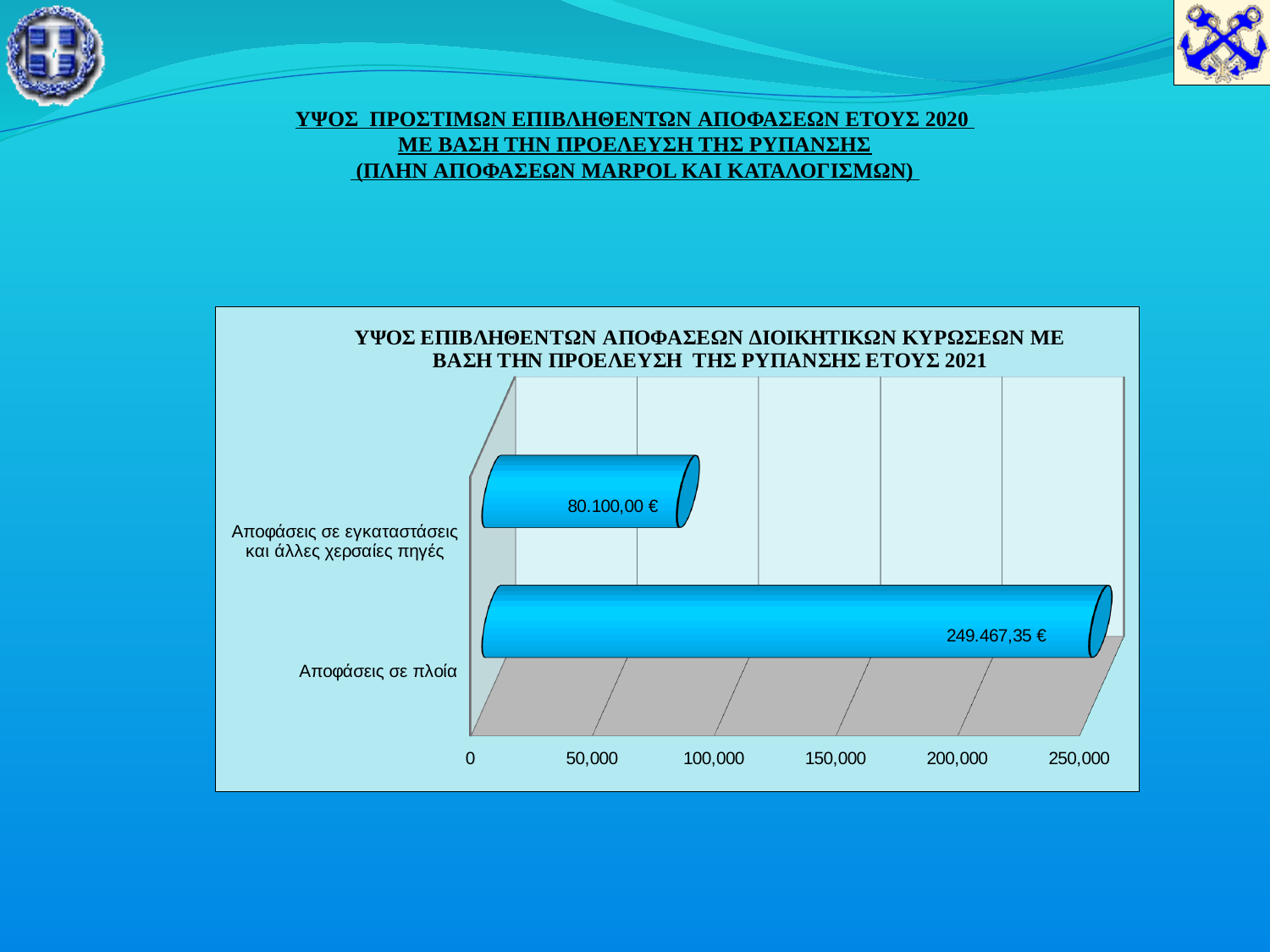
What is the value for Αποφάσεις σε πλοία? 249.467,35 € What is the value for Αποφάσεις σε εγκαταστάσεις και άλλες χερσαίες πηγές? 80.100,00 € What is the difference between the value for Αποφάσεις σε πλοία and the value for Αποφάσεις σε εγκαταστάσεις και άλλες χερσαίες πηγές? 169.367,35 € Is the value for Αποφάσεις σε εγκαταστάσεις και άλλες χερσαίες πηγές greater or less than 100,000? less What kind of chart is shown on the slide? bar chart How many categories are shown in the chart? 2 Which is larger: the value for Αποφάσεις σε πλοία or the value for Αποφάσεις σε εγκαταστάσεις και άλλες χερσαίες πηγές? Αποφάσεις σε πλοία Is the value for Αποφάσεις σε πλοία greater or less than 200,000? greater What is the title of the chart? ΥΨΟΣ ΕΠΙΒΛΗΘΕΝΤΩΝ ΑΠΟΦΑΣΕΩΝ ΔΙΟΙΚΗΤΙΚΩΝ ΚΥΡΩΣΕΩΝ ΜΕ ΒΑΣΗ ΤΗΝ ΠΡΟΕΛΕΥΣΗ ΤΗΣ ΡΥΠΑΝΣΗΣ ΕΤΟΥΣ 2021 Which category has the lowest value? Αποφάσεις σε εγκαταστάσεις και άλλες χερσαίες πηγές Which category has the highest value? Αποφάσεις σε πλοία What is the maximum value shown on the horizontal axis of the chart? 250,000